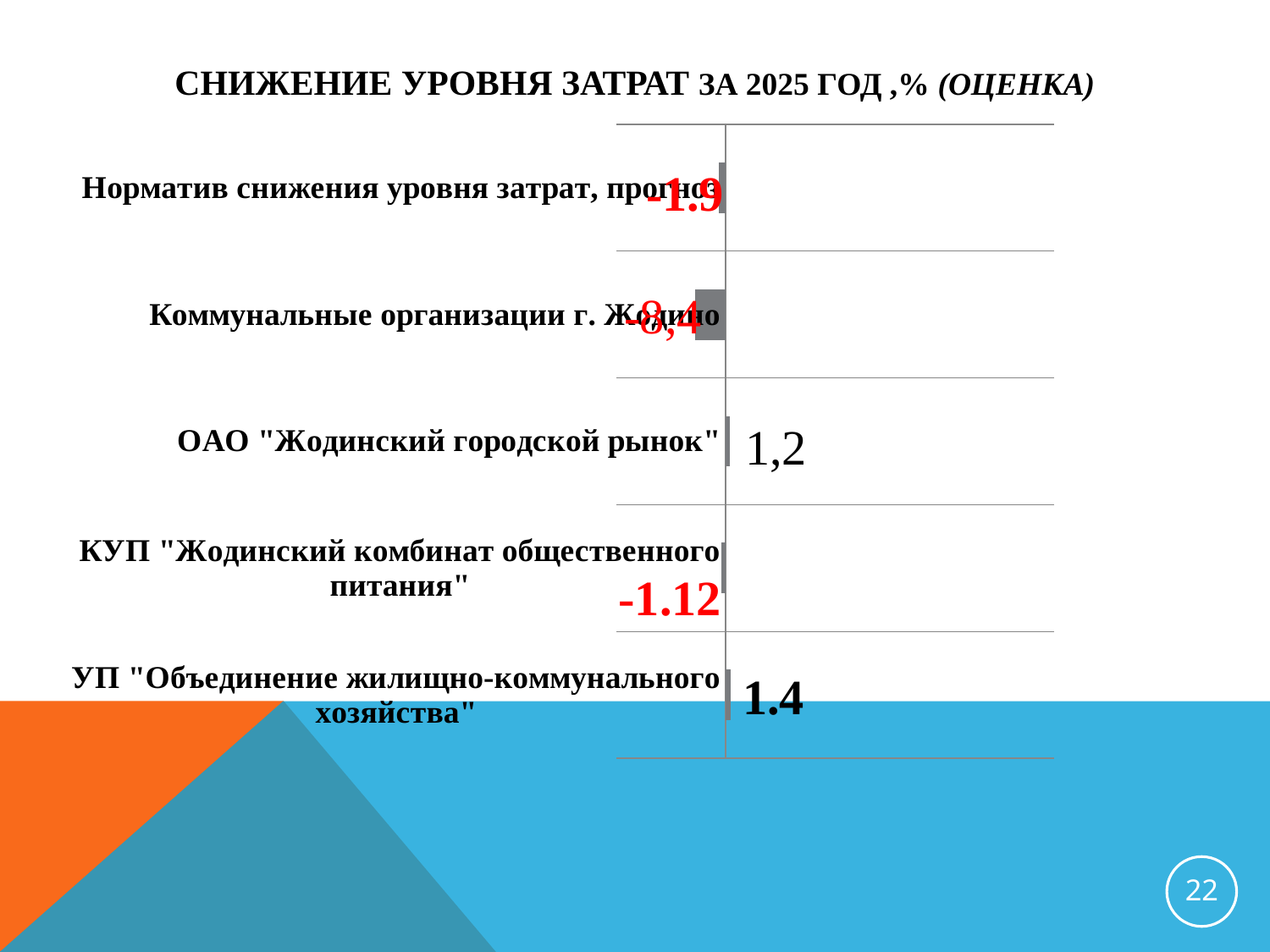
What is the value for Норматив снижения уровня затрат, прогноз? -1.9 What is the title of the chart? СНИЖЕНИЕ УРОВНЯ ЗАТРАТ ЗА 2025 ГОД ,% (ОЦЕНКА) Which is larger: the value for ОАО "Жодинский городской рынок" or the value for КУП "Жодинский комбинат общественного питания"? ОАО "Жодинский городской рынок" Which category has the highest value? УП "Объединение жилищно-коммунального хозяйства" What is the difference between the values for УП "Объединение жилищно-коммунального хозяйства" and ОАО "Жодинский городской рынок"? 0.2 What is the value for УП "Объединение жилищно-коммунального хозяйства"? 1.4 What is the value for Коммунальные организации г. Жодино? -8,4 What is the value for ОАО "Жодинский городской рынок"? 1,2 How many categories are shown in the chart? 5 What kind of chart is shown on the slide? Bar chart What is the value for КУП "Жодинский комбинат общественного питания"? -1.12 Which category has the lowest value? Коммунальные организации г. Жодино